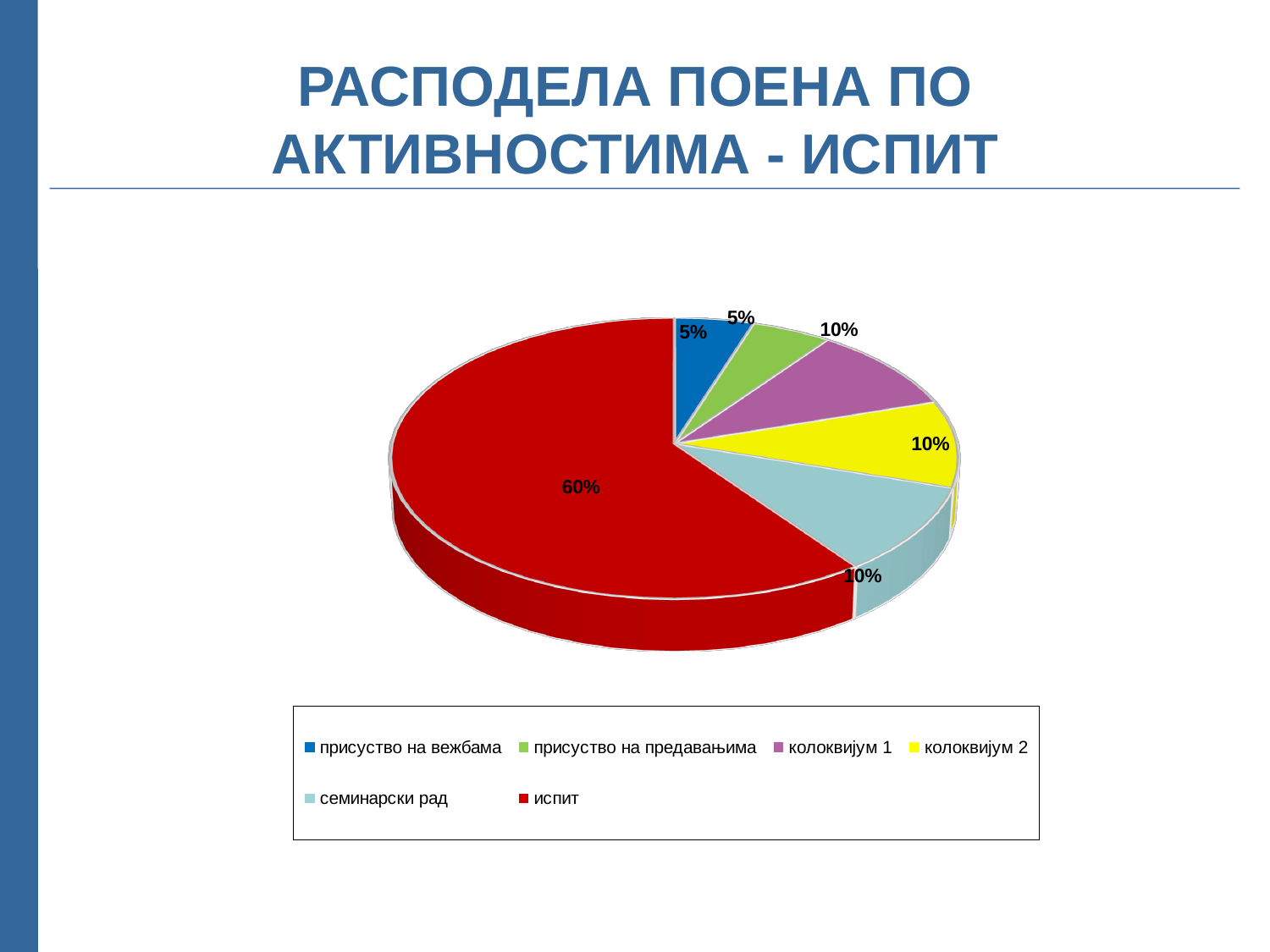
What is the title of the chart on the slide? РАСПОДЕЛА ПОЕНА ПО АКТИВНОСТИМА - ИСПИТ What kind of chart is shown on the slide? pie chart How many slices does the pie chart have? 6 What share of the pie does семинарски рад take? 10% What share of the pie does испит take? 60% What share of the pie does присуство на вежбама take? 5% What is the difference between the share for испит and the share for колоквијум 2? 50% Which is larger, the share for колоквијум 1 or the share for присуство на предавањима? колоквијум 1 What colour is the slice for испит? red What is the difference between the share for семинарски рад and the share for присуство на вежбама? 5% Which category has the largest slice of the pie? испит